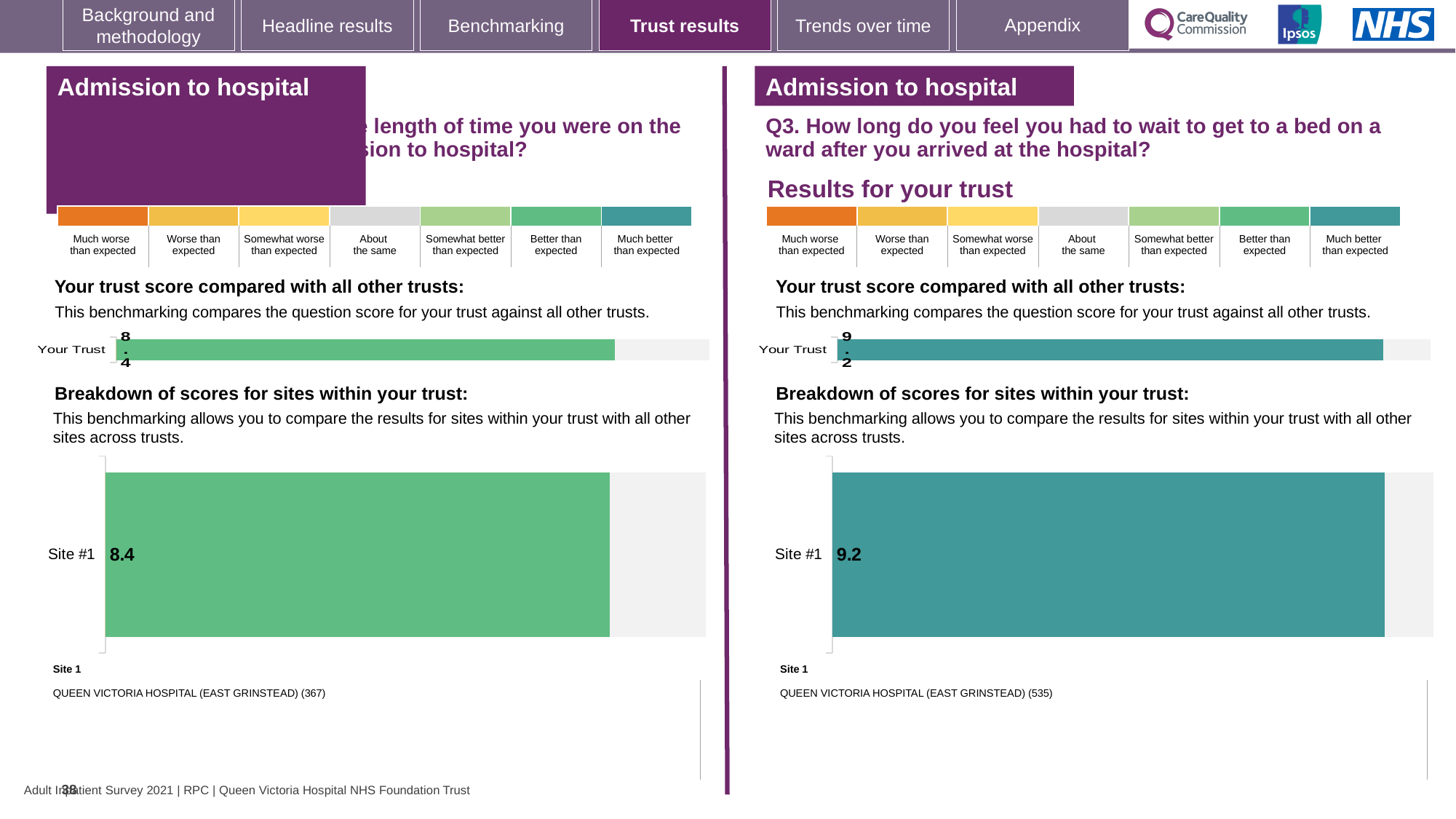
What colour is the Site #1 bar in the right-hand site breakdown chart (Q3)? Teal How many sites are shown in the right-hand 'Breakdown of scores for sites within your trust' chart? 1 On the left half of the slide, what is the 'Your Trust' score shown in the trust benchmarking bar chart? 8.4 In the left-hand 'Breakdown of scores for sites within your trust' chart, what is the score for Site #1? 8.4 In the right-hand 'Breakdown of scores for sites within your trust' chart (Q3), what is the score for Site #1? 9.2 What type of chart is used to show the Site #1 score in the left-hand site breakdown? Bar chart Which is larger: the Site #1 score in the left-hand site breakdown chart or the Site #1 score in the right-hand site breakdown chart? The right-hand chart (9.2) What is the difference between the Site #1 score in the right-hand site breakdown chart and the Site #1 score in the left-hand site breakdown chart? 0.8 Is the 'Your Trust' score in the right-hand trust benchmarking chart greater or less than 9? greater On the right half of the slide (Q3), what is the 'Your Trust' score shown in the trust benchmarking bar chart? 9.2 Which site name is listed as Site 1 beneath the right-hand site breakdown chart? QUEEN VICTORIA HOSPITAL (EAST GRINSTEAD) (535) How many sites are shown in the left-hand 'Breakdown of scores for sites within your trust' chart? 1